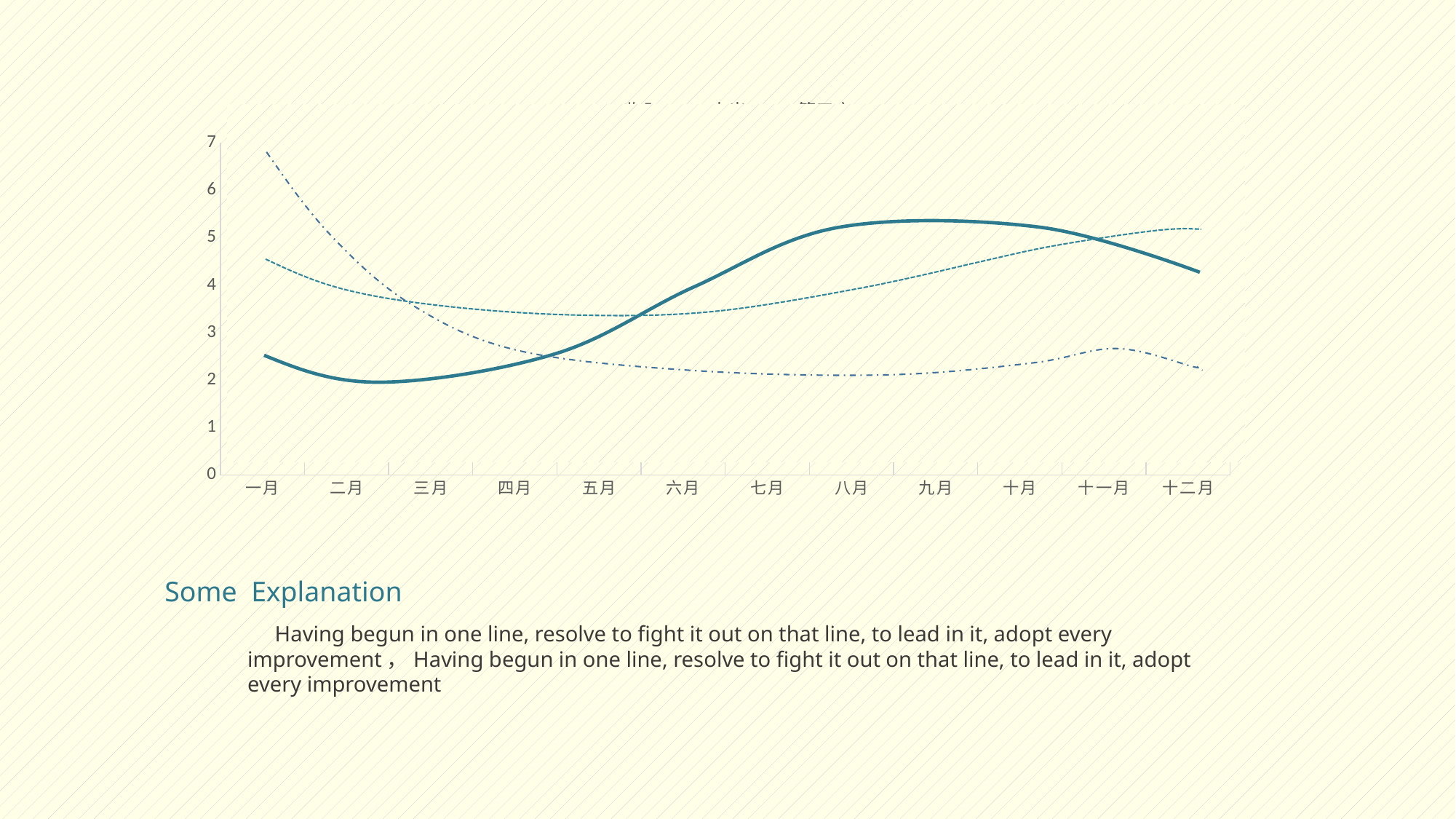
Does the dash-dot line rise or fall from 一月 to 八月? fall At 九月, which line has the higher value, the solid line or the dash-dot line? the solid line In which month does the dash-dot line reach its highest value? 一月 Is the value of the dashed line at 十二月 greater or less than 4? greater How many categories are shown along the x axis of the chart? 12 Is the value of the solid line at 九月 greater or less than 5? greater What kind of chart is shown on the slide? line chart At 一月, which line has the higher value, the solid line or the dash-dot line? the dash-dot line Is the value of the dashed line at 七月 greater or less than 4? less How many lines are plotted on the chart? 3